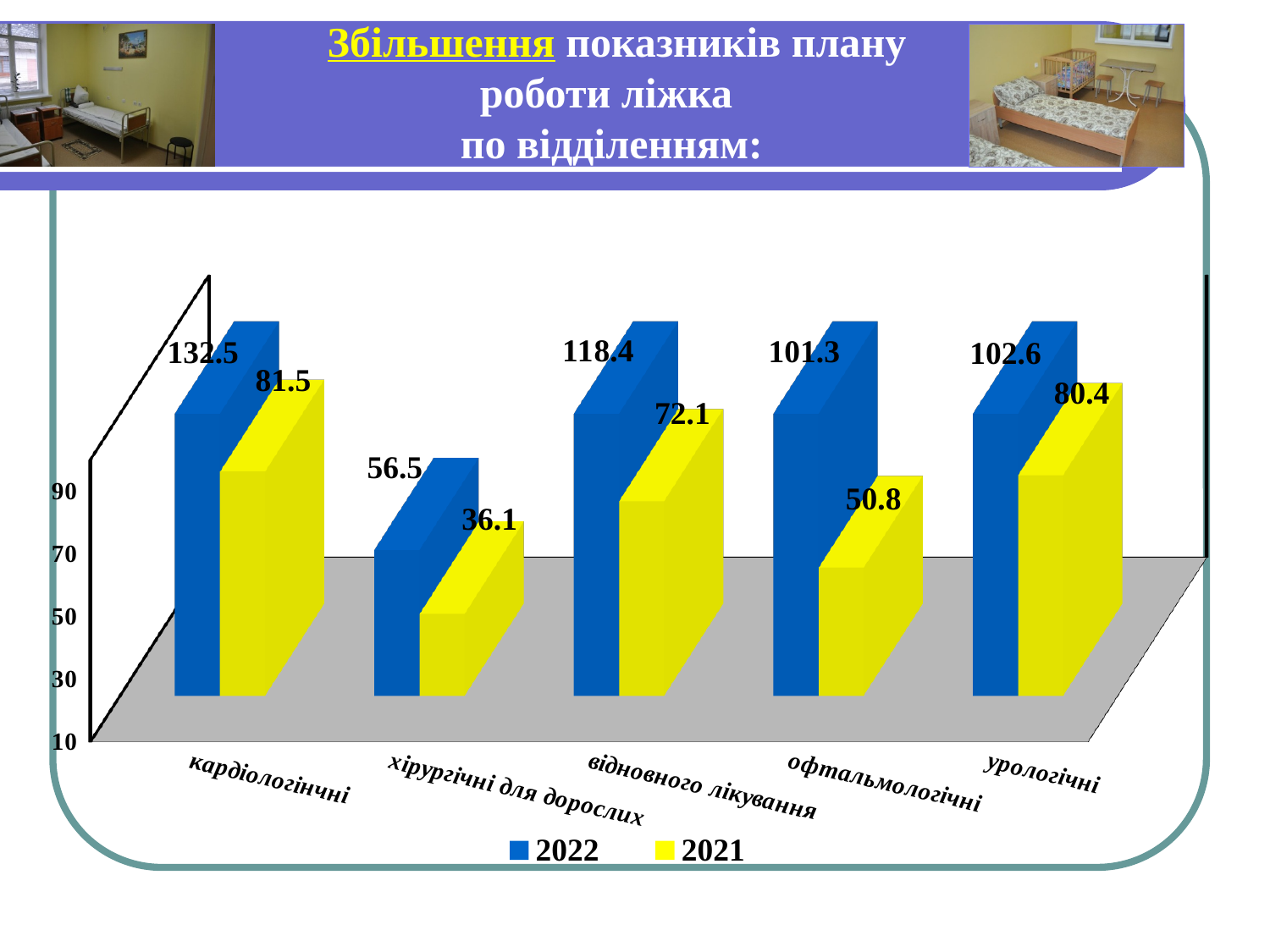
How many series does the legend list? 2 Which is larger: the 2022 value for урологічні or the 2022 value for офтальмологічні? урологічні What is the 2021 value for урологічні? 80.4 What is the 2021 value for офтальмологічні? 50.8 Which colour represents the 2021 series? yellow What is the 2022 value for відновного лікування? 118.4 How many categories are shown on the x axis? 5 What is the 2022 value for кардіологінчні? 132.5 Which category has the lowest 2021 value? хірургічні для дорослих What is the difference between the 2022 and 2021 values for хірургічні для дорослих? 20.4 What kind of chart is shown on the slide? bar chart Which category has the highest 2022 value? кардіологінчні